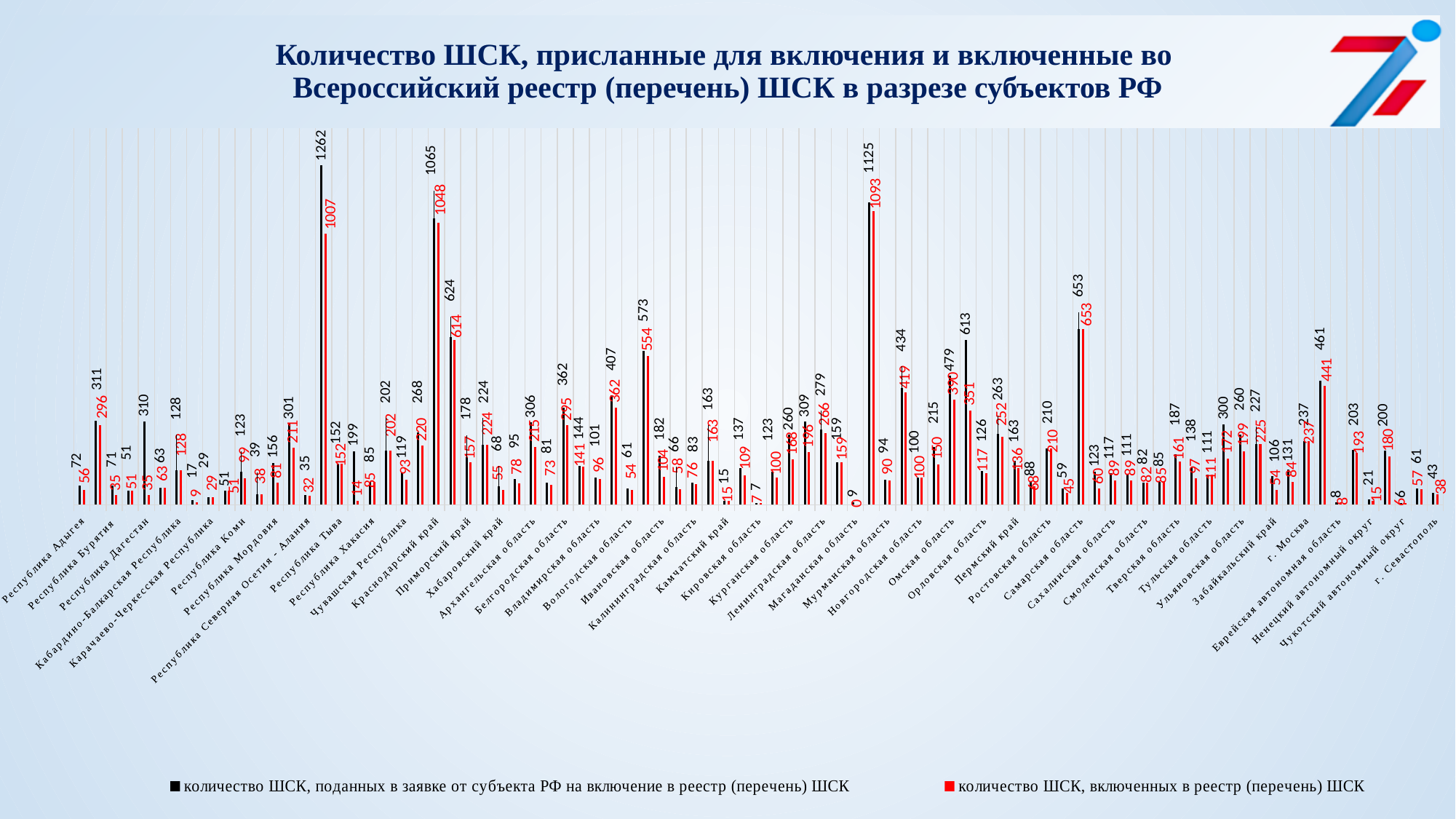
What is the value of the red series for г. Москва? 237 What is the highest value shown for the black series on the chart? 1262 What is the value of the red series for г. Севастополь? 38 What is the value of the black series (количество ШСК, поданных в заявке) for Краснодарский край? 1065 What is the difference between the submitted (black) and included (red) values for Краснодарский край? 17 What is the value of the black series for Омская область? 479 What is the difference between the black and red values for Омская область? 89 Which has a larger black-series value, Самарская область or Омская область? Самарская область How many series does the legend list? 2 What is the value of the red series (количество ШСК, включенных в реестр) for Краснодарский край? 1048 What kind of chart is shown on the slide? bar chart What is the value of the black series for Самарская область? 653